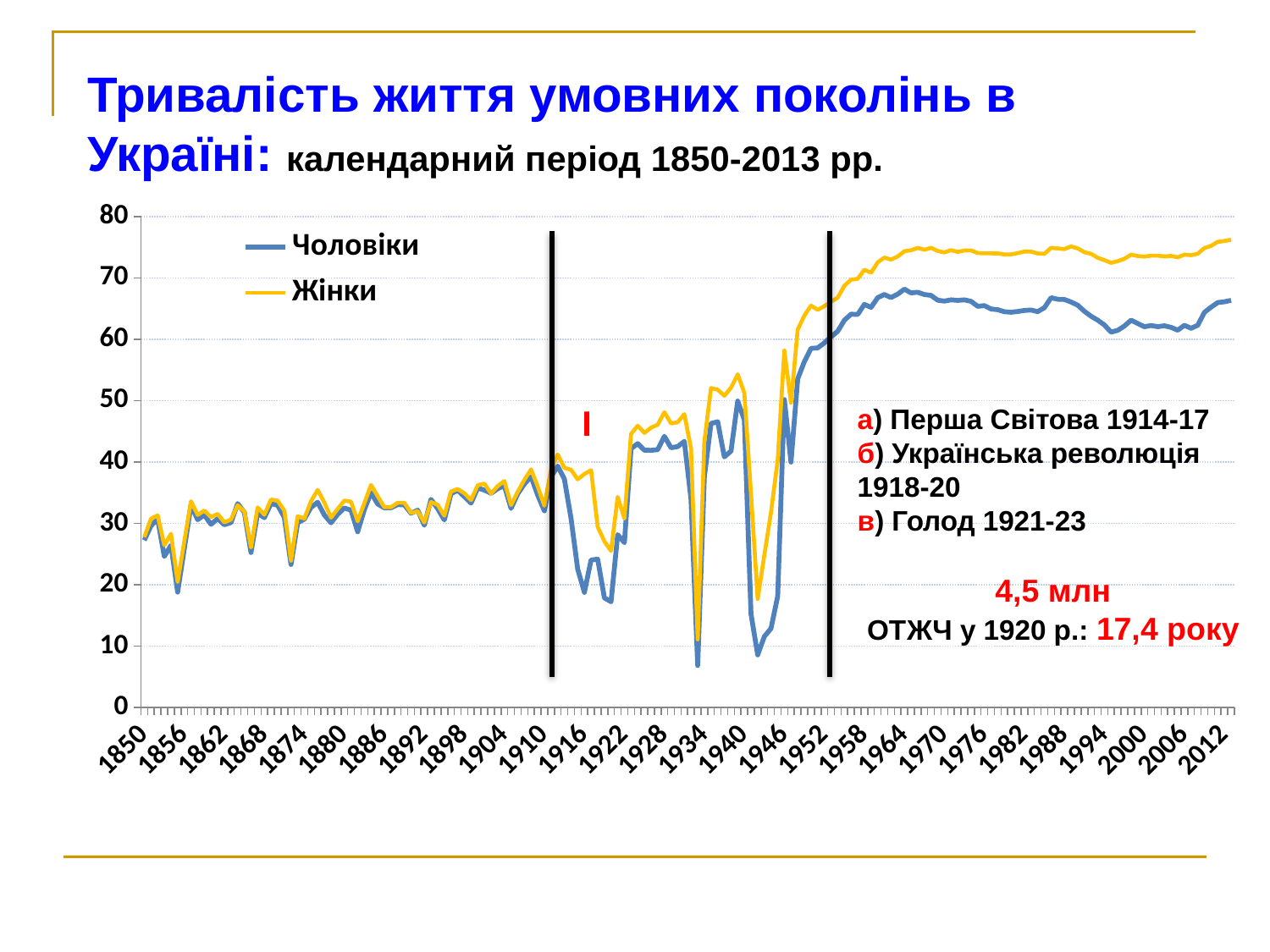
Is the value for Чоловіки in 2012 greater or less than 60? greater Which series is drawn in yellow? Жінки According to the annotation on the chart, what was ОТЖЧ у 1920 р.? 17,4 року Around 1920, which series has the higher value, Чоловіки or Жінки? Жінки Is the value for Жінки in 2012 greater or less than 70? greater Between 1946 and 1964, do the values for Жінки rise or fall? rise What are the two series named in the legend? Чоловіки and Жінки What kind of chart is shown on the slide? line chart Is the value for Чоловіки in 1850 greater or less than 40? less How many series does the chart's legend list? 2 In 2012, which series has the higher value, Чоловіки or Жінки? Жінки